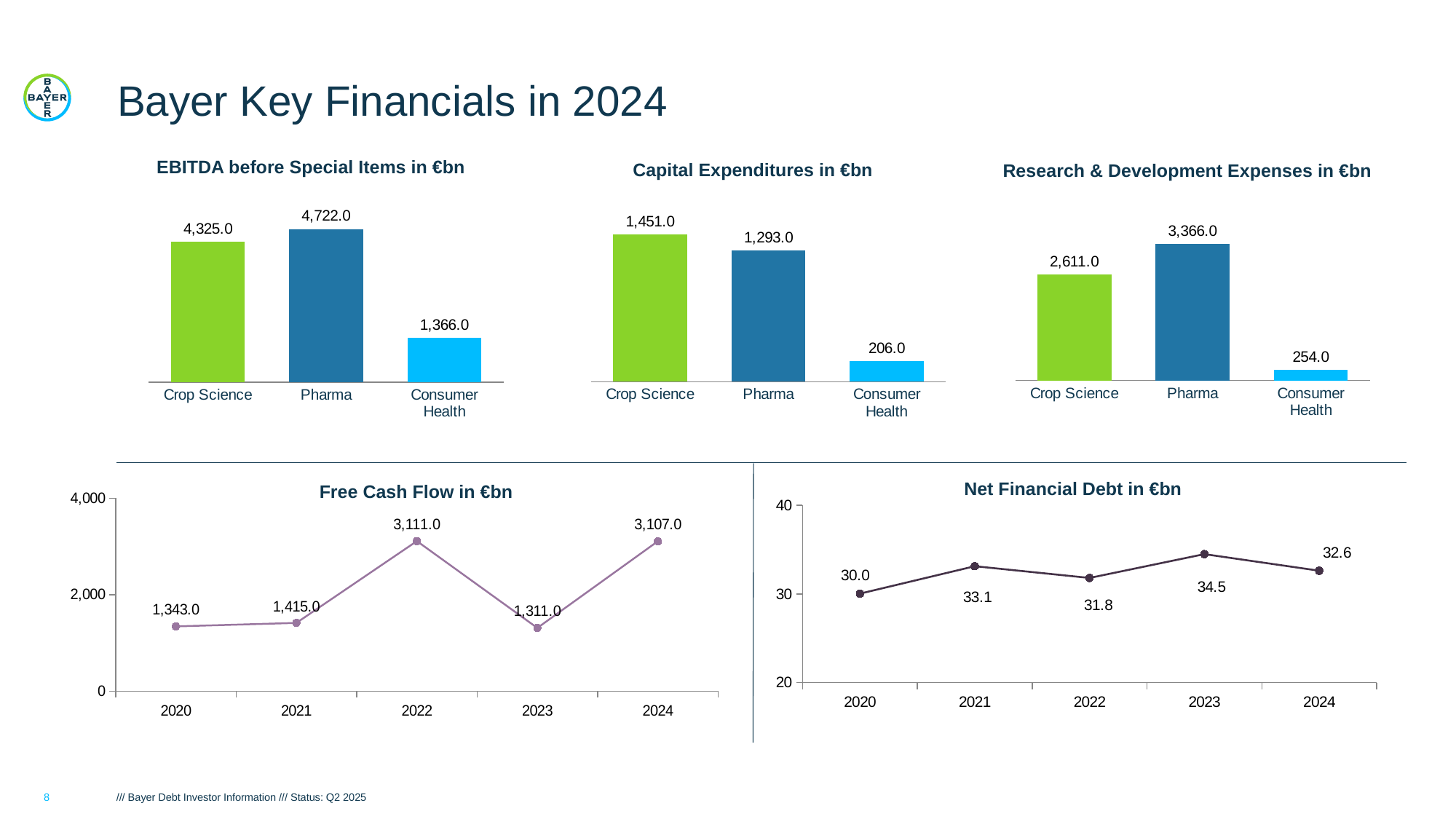
In the 'Research & Development Expenses in €bn' chart, which category has the highest value? Pharma In the 'Net Financial Debt in €bn' chart, which year has the highest value? 2023 In the 'Research & Development Expenses in €bn' chart, what is the value for Consumer Health? 254.0 In the 'Net Financial Debt in €bn' chart, what is the difference between 2023 and 2024? 1.9 In the 'Capital Expenditures in €bn' chart, what is the difference between Crop Science and Pharma? 158.0 In the 'Research & Development Expenses in €bn' chart, which is larger, Crop Science or Pharma? Pharma In the 'Free Cash Flow in €bn' chart, how many years are plotted? 5 In the 'Capital Expenditures in €bn' chart, what is the value for Crop Science? 1,451.0 In the 'Free Cash Flow in €bn' chart, what is the value for 2022? 3,111.0 What kind of chart is the 'Free Cash Flow in €bn' chart? Line chart In the 'EBITDA before Special Items in €bn' chart, what is the value for Pharma? 4,722.0 In the 'EBITDA before Special Items in €bn' chart, which category has the lowest value? Consumer Health